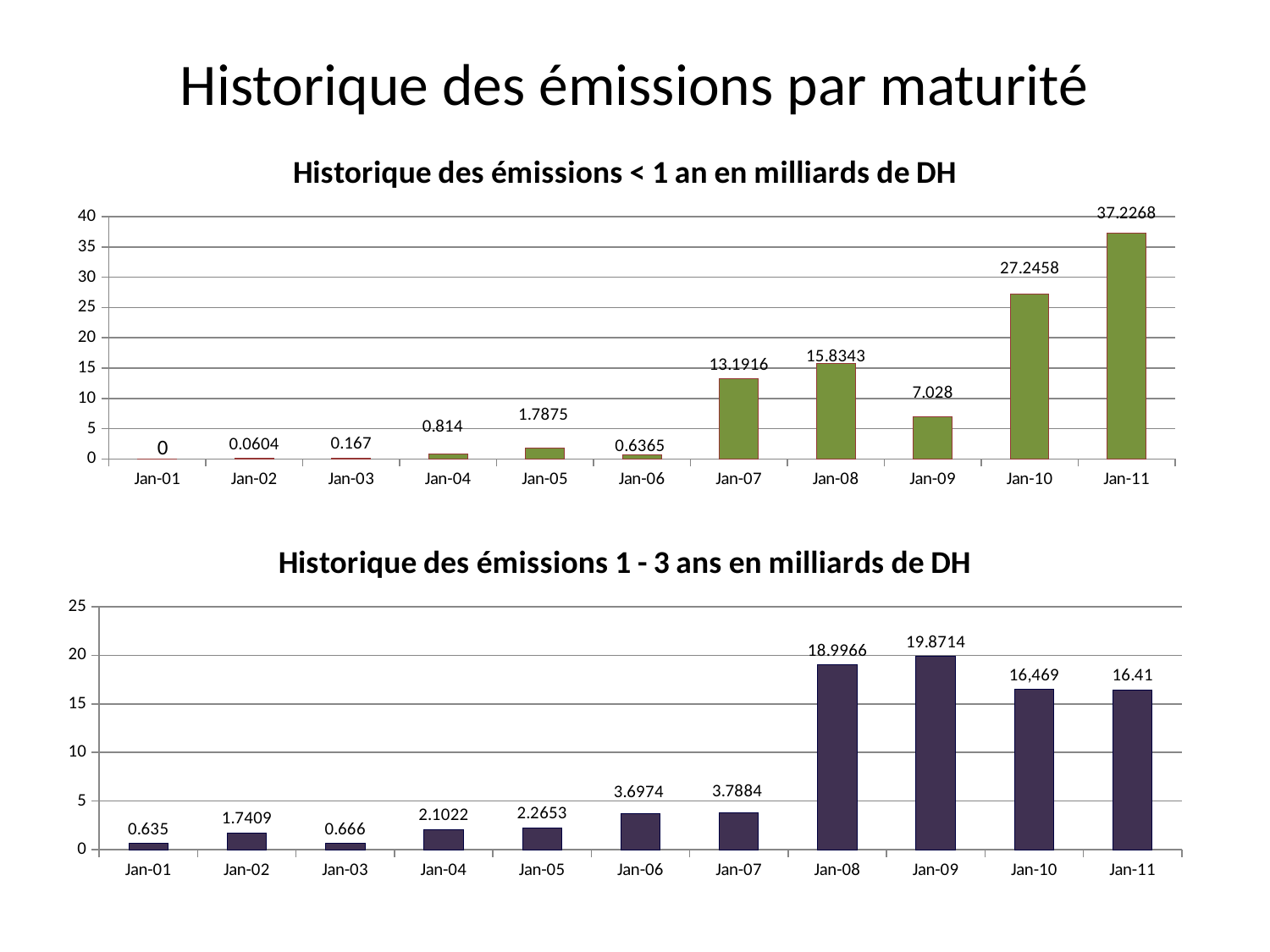
In the top chart (Historique des émissions < 1 an), what is the value for Jan-11? 37.2268 In the top chart (Historique des émissions < 1 an), which year has the lowest value? Jan-01 What type of chart is the top chart (Historique des émissions < 1 an)? Bar chart In the top chart (Historique des émissions < 1 an), what is the difference between the values for Jan-11 and Jan-10? 9.981 In the bottom chart (Historique des émissions 1 - 3 ans), what is the value for Jan-10? 16,469 In the top chart (Historique des émissions < 1 an), is the value for Jan-08 greater or less than 15? greater In the bottom chart (Historique des émissions 1 - 3 ans), which is larger, the value for Jan-07 or the value for Jan-08? Jan-08 In the bottom chart (Historique des émissions 1 - 3 ans), what is the value for Jan-08? 18.9966 How many years are shown on the x axis of the bottom chart (Historique des émissions 1 - 3 ans)? 11 In the bottom chart (Historique des émissions 1 - 3 ans), which year has the highest value? Jan-09 In the top chart (Historique des émissions < 1 an), what is the value for Jan-09? 7.028 In the top chart (Historique des émissions < 1 an), which year has the highest value? Jan-11